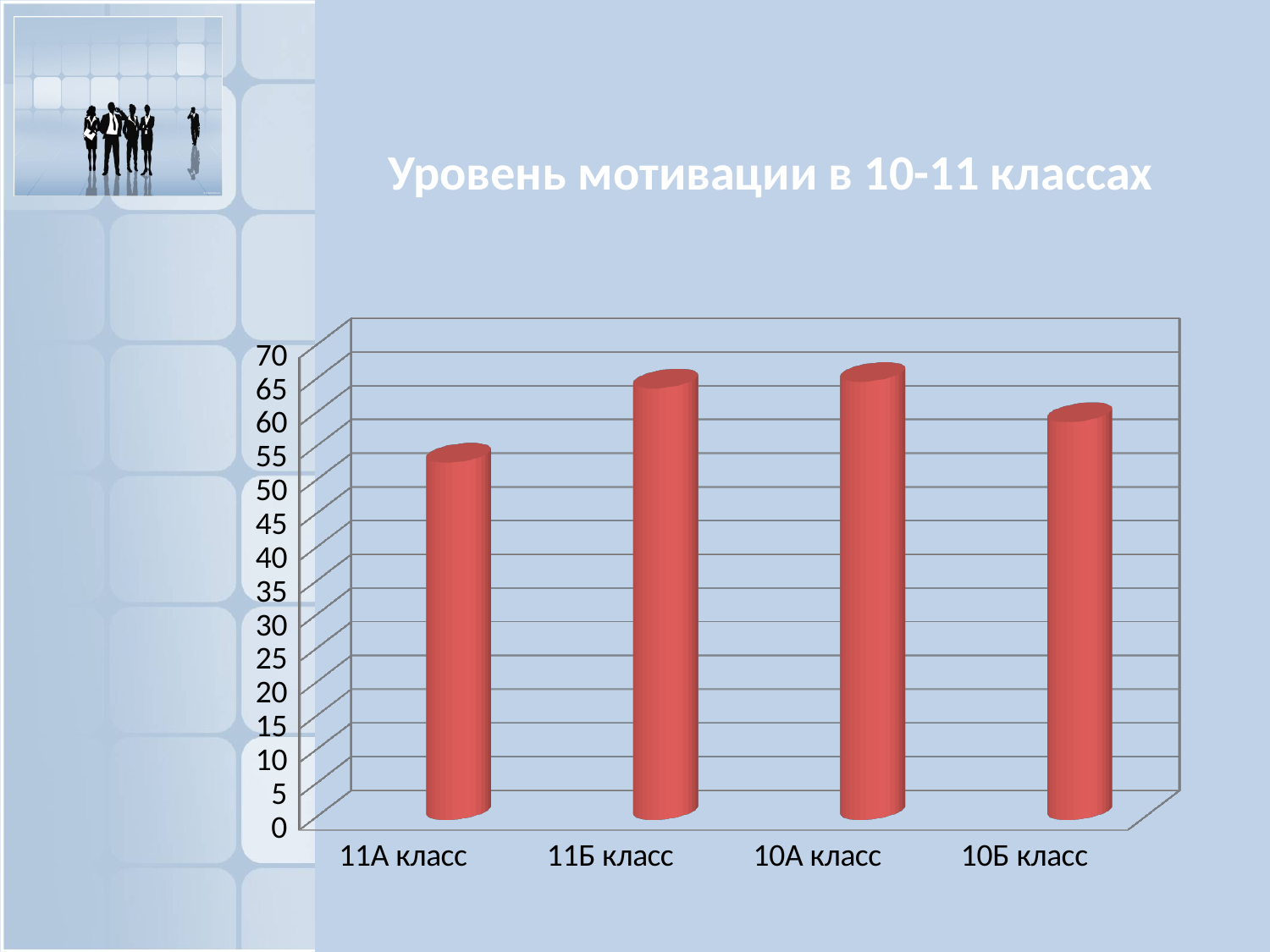
How many classes are shown on the x axis of the chart? 4 Which has the higher value, 11А класс or 11Б класс? 11Б класс Is the value for 10А класс greater or less than 60? greater What is the title of the chart? Уровень мотивации в 10-11 классах Which class has the lowest level of motivation in the chart? 11А класс Is the value for 10Б класс greater or less than 50? greater Which has the higher value, 10А класс or 10Б класс? 10А класс Is the value for 11А класс greater or less than 60? less What kind of chart is shown on the slide? bar chart What colour are the bars in the chart? red